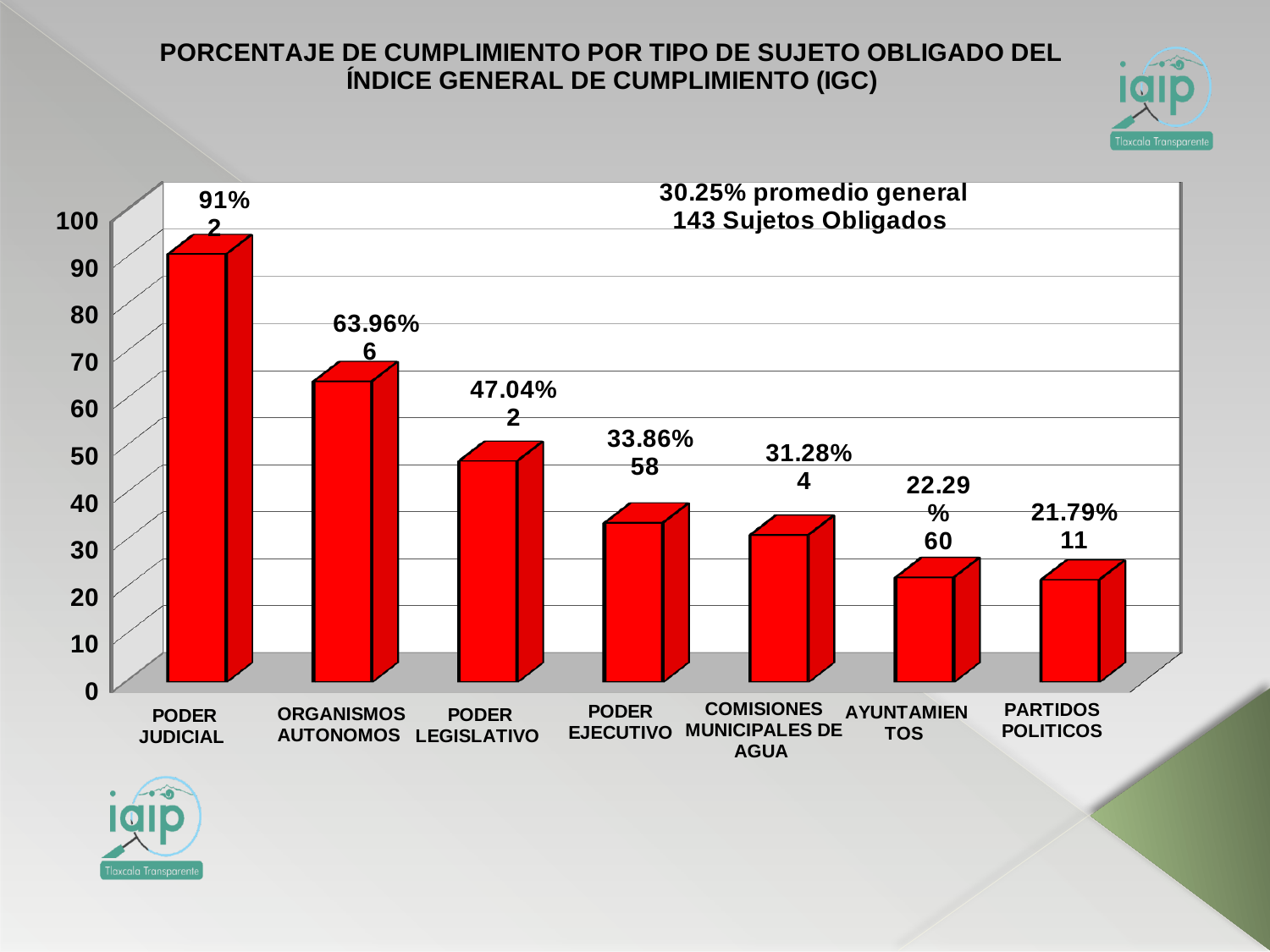
What overall average (promedio general) is stated on the chart? 30.25% What is the compliance percentage shown for PODER JUDICIAL? 91% What is the compliance percentage shown for ORGANISMOS AUTONOMOS? 63.96% Which has a higher compliance percentage, PODER LEGISLATIVO or COMISIONES MUNICIPALES DE AGUA? PODER LEGISLATIVO How many categories are shown on the x axis of the chart? 7 What kind of chart is shown on the slide? Bar chart Which category has the highest compliance percentage? PODER JUDICIAL Do the compliance percentages rise or fall from left to right along the x axis? Fall What is the compliance percentage shown for PARTIDOS POLITICOS? 21.79% Which category has the lowest compliance percentage? PARTIDOS POLITICOS What is the compliance percentage shown for PODER EJECUTIVO? 33.86% What is the difference in compliance percentage between PODER JUDICIAL and ORGANISMOS AUTONOMOS? 27.04%